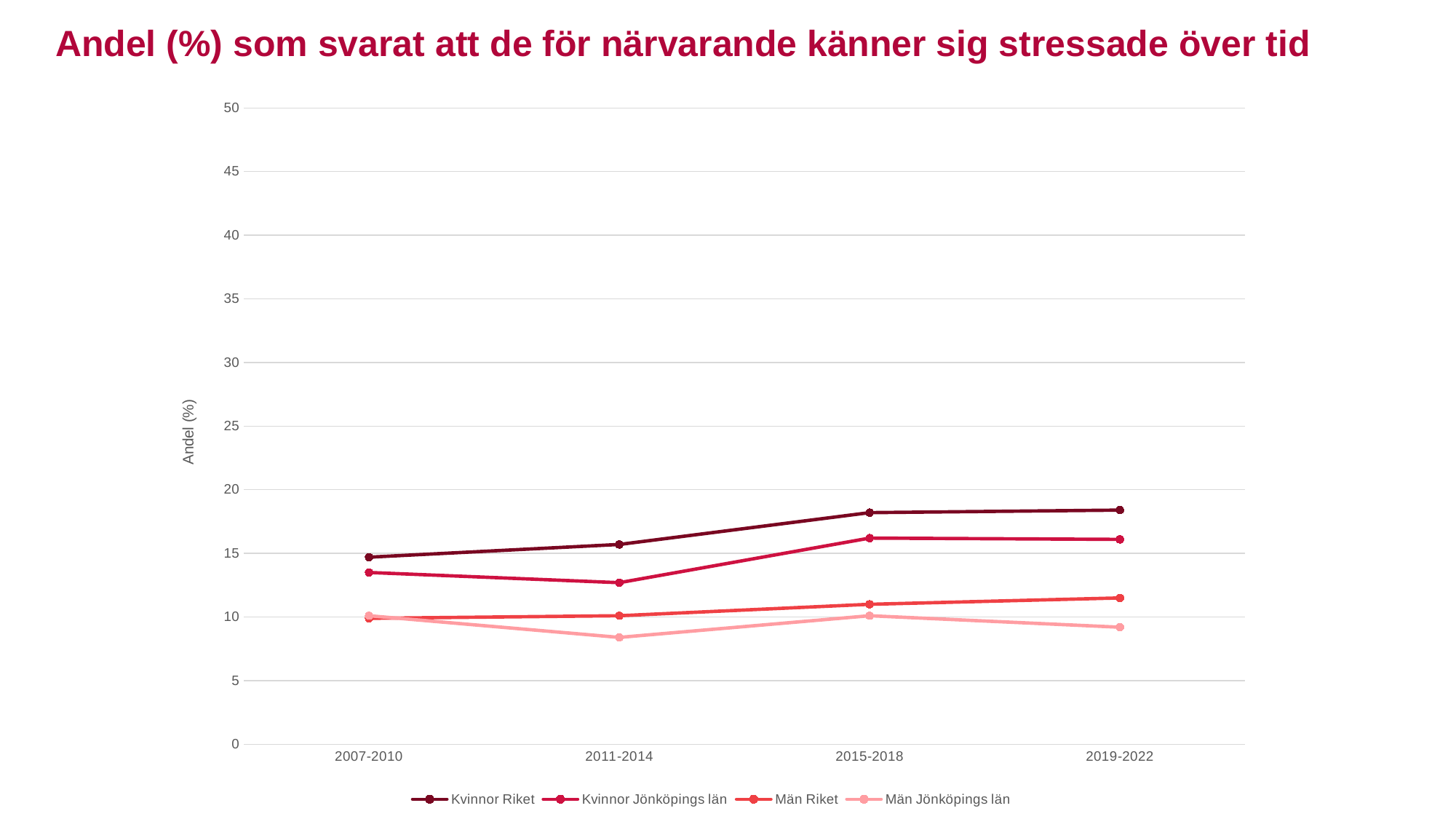
Is the value for Män Jönköpings län in 2011-2014 greater or less than 10? less What kind of chart is shown on the slide? line chart Does the Kvinnor Riket line rise or fall from 2007-2010 to 2019-2022? rise Which series has the lowest value in 2011-2014? Män Jönköpings län In 2007-2010, which is larger: Kvinnor Jönköpings län or Män Riket? Kvinnor Jönköpings län Is the value for Män Riket in 2019-2022 greater or less than 10? greater What is the label on the y axis? Andel (%) How many time periods are shown on the x axis? 4 Which series has the highest value in 2019-2022? Kvinnor Riket Is the value for Kvinnor Riket in 2015-2018 greater or less than 15? greater How many series does the legend list? 4